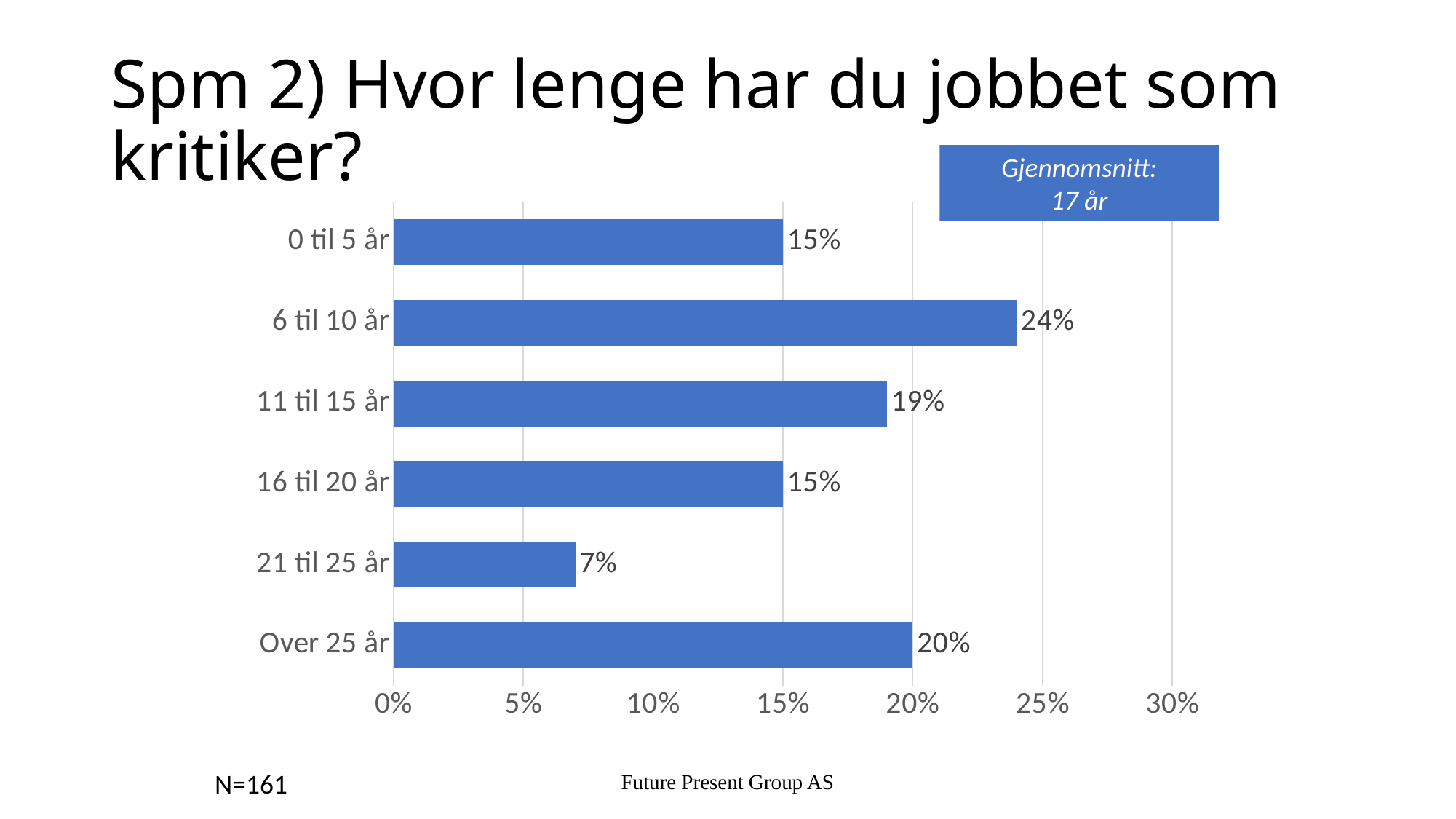
What is the value for the '21 til 25 år' category? 7% What is the value for the '6 til 10 år' category? 24% What is the value for the 'Over 25 år' category? 20% What average (Gjennomsnitt) is stated in the box on the slide? 17 år What is the difference between the values for 'Over 25 år' and '11 til 15 år'? 1% Which category has the highest value? 6 til 10 år What kind of chart is shown on the slide? bar chart Is the value for '6 til 10 år' greater or less than 20%? greater How many categories are shown in the chart? 6 Which category has the lowest value? 21 til 25 år What is the difference between the values for '6 til 10 år' and '21 til 25 år'? 17% Which is larger, the value for '11 til 15 år' or the value for '16 til 20 år'? 11 til 15 år